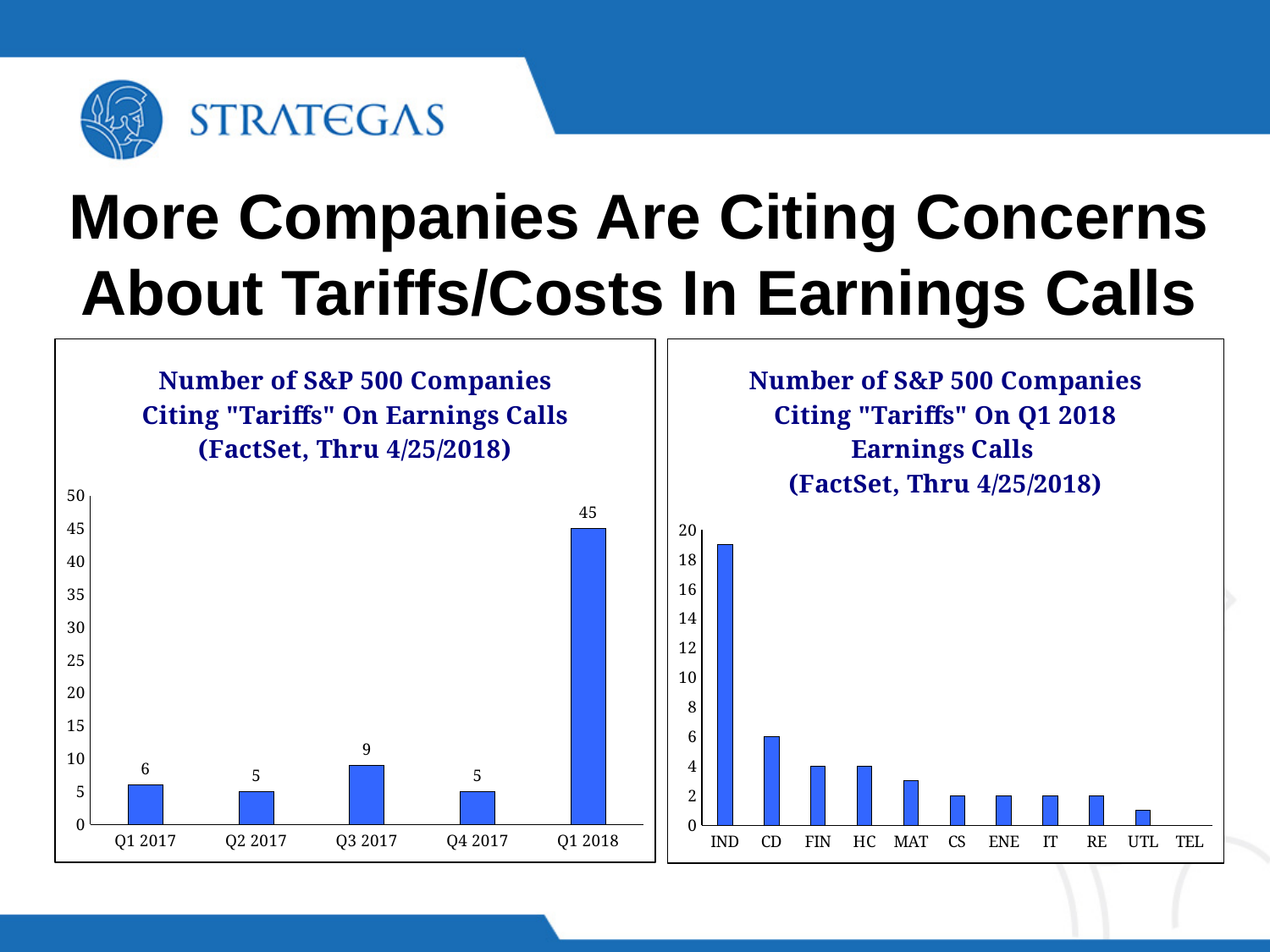
On the right chart, is the value for IND greater or less than 10? greater On the left chart, what is the value for Q3 2017? 9 On the right chart, which sector has the highest number of companies citing "tariffs"? IND On the left chart, what is the difference between the Q1 2018 value and the Q4 2017 value? 40 What kind of chart is the left chart? Bar chart On the left chart, which is larger, the value for Q1 2017 or the value for Q3 2017? Q3 2017 On the right chart, how many sectors are shown on the x axis? 11 On the left chart, how many S&P 500 companies cited "tariffs" on Q1 2018 earnings calls? 45 On the left chart, how many quarters are shown on the x axis? 5 On the right chart, is the value for UTL greater or less than 2? less On the left chart, which quarter has the highest number of companies citing "tariffs"? Q1 2018 On the right chart, what is the value for CD? 6